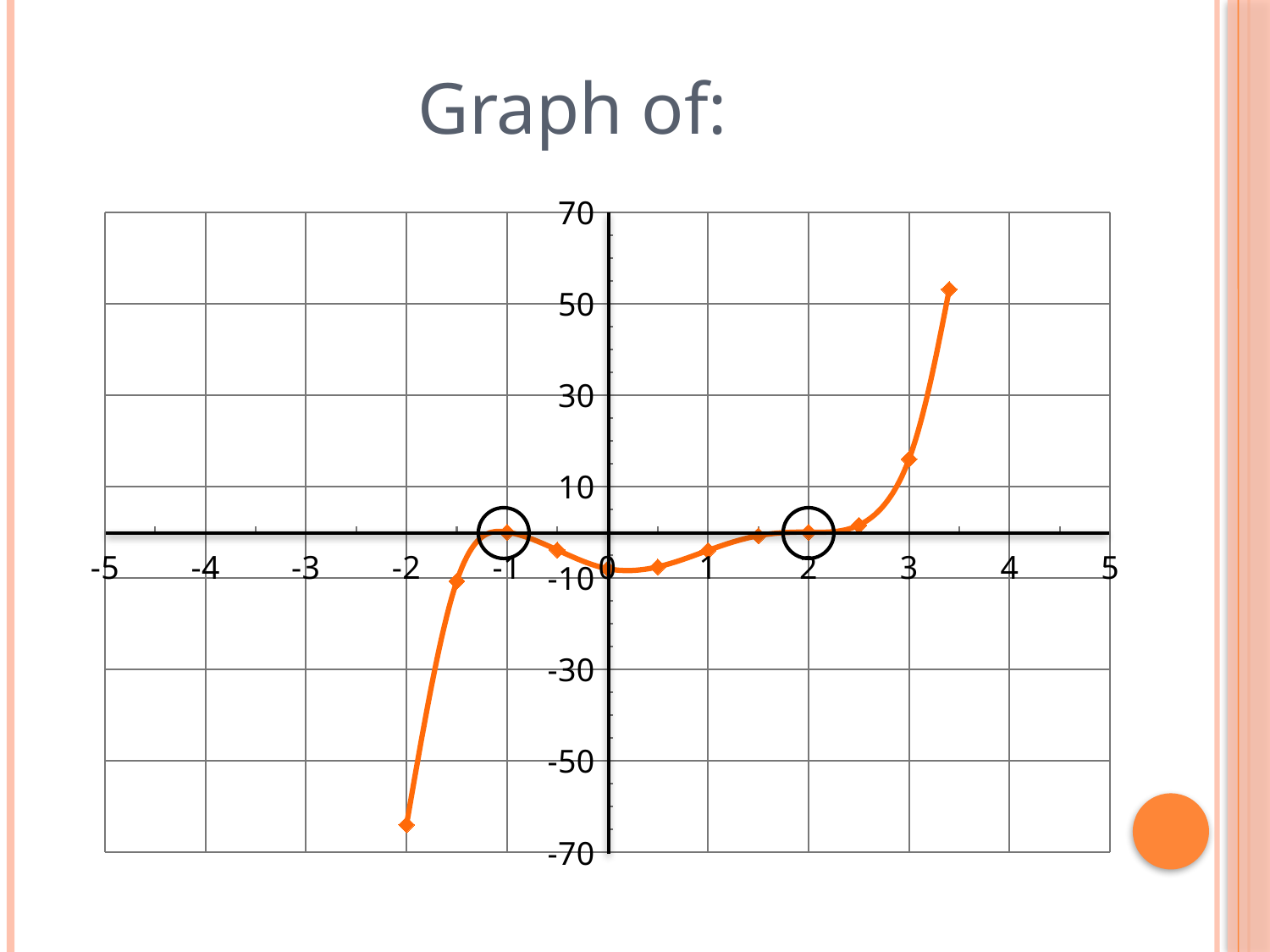
What is the title of the slide above the chart? Graph of: What kind of chart is shown on the slide? line chart What is the highest value labelled on the y axis? 70 Does the curve rise or fall as x increases from -1 to 0? fall Is the y value of the curve at x = -1.5 greater or less than -30? greater Which has the larger y value: the point at x = 3 or the point at x = 1? x = 3 Is the y value of the curve at x = -2 greater or less than -50? less At which x value does the curve reach its lowest plotted point? -2 At which x values are the two circled points on the curve located? -1 and 2 Is the y value of the curve at x = 3 greater or less than 10? greater Does the curve rise or fall as x increases from 2 to 3? rise